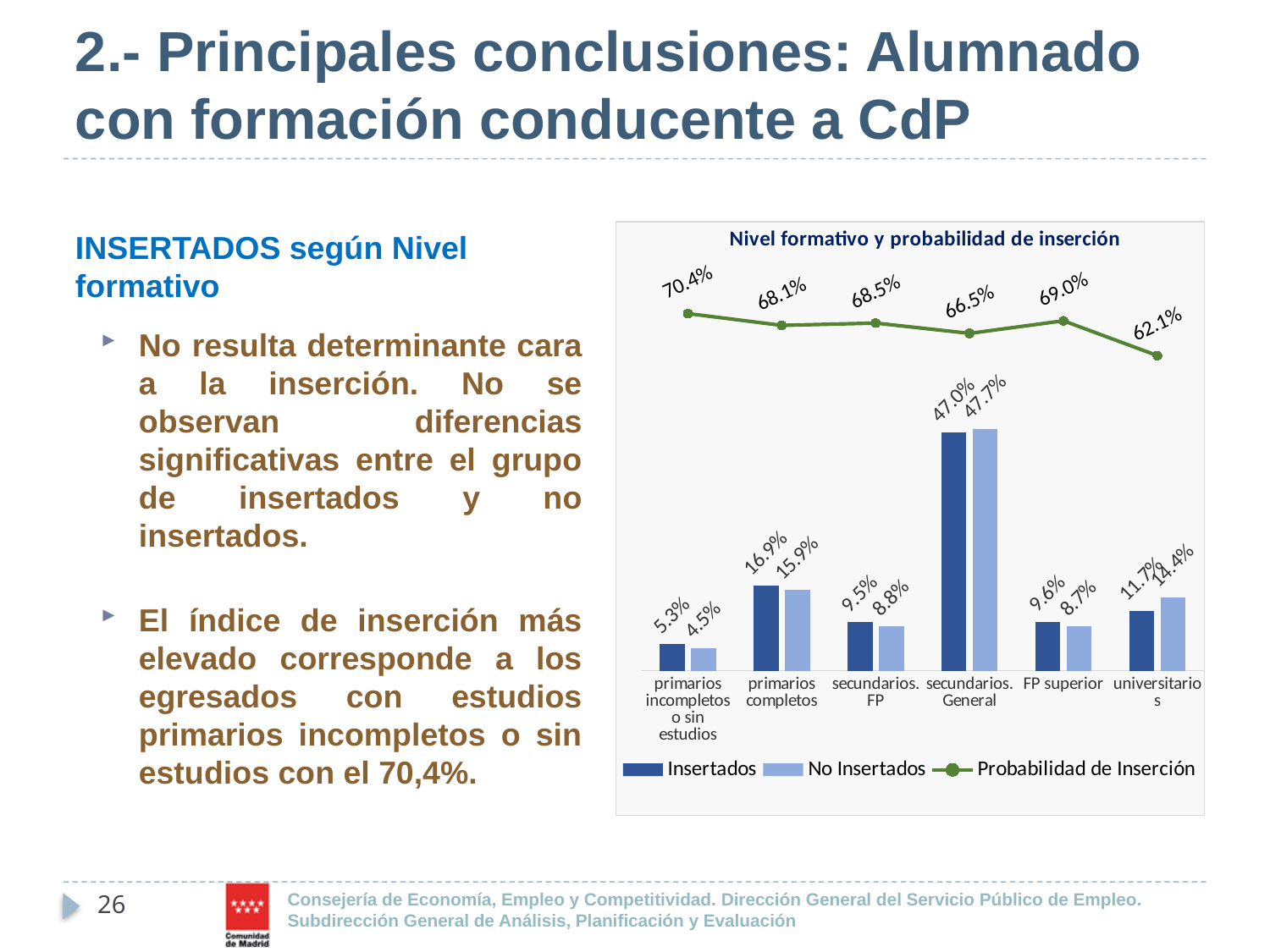
What is the Insertados value for secundarios. General? 47.0% What is the difference between the Insertados and No Insertados values for primarios completos? 1.0% What is the Probabilidad de Inserción for FP superior? 69.0% What is the No Insertados value for universitarios? 14.4% Which category has the highest Probabilidad de Inserción? primarios incompletos o sin estudios What is the Probabilidad de Inserción for primarios incompletos o sin estudios? 70.4% Which category has the lowest Probabilidad de Inserción? universitarios Which is larger for universitarios: Insertados or No Insertados? No Insertados What is the title of the chart? Nivel formativo y probabilidad de inserción Which category has the lowest Insertados value? primarios incompletos o sin estudios How many series does the legend list? 3 How many categories are shown on the x axis? 6